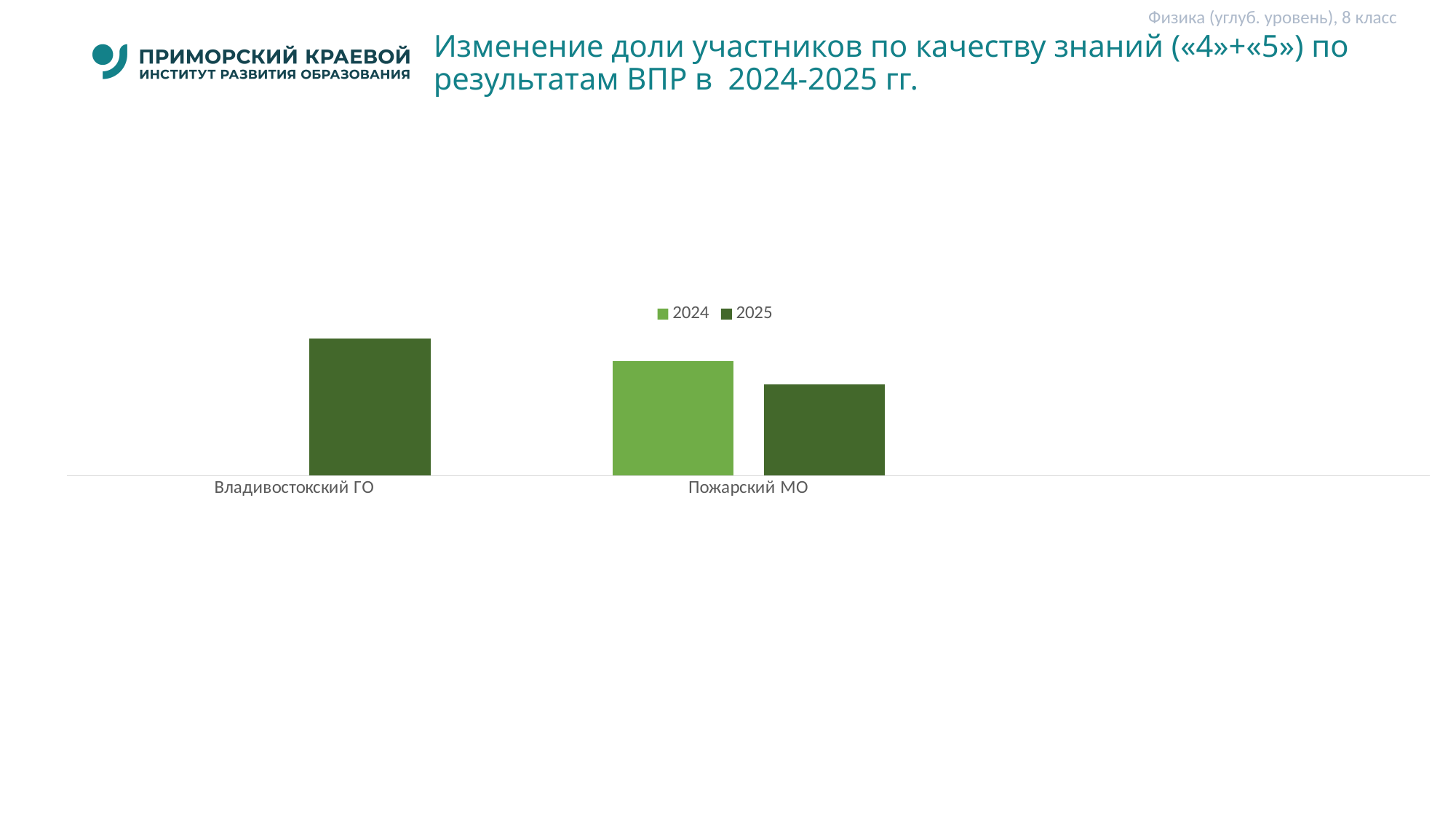
Which series does the legend list: what are the two entries? 2024 and 2025 Which category has the lowest 2025 bar? Пожарский МО Which category is shown on the left of the x axis? Владивостокский ГО Which category has a bar for only one of the two years? Владивостокский ГО What kind of chart is shown on the slide? bar chart How many series does the chart legend list? 2 Which category has the higher 2025 value, Владивостокский ГО or Пожарский МО? Владивостокский ГО Did the value for Пожарский МО rise or fall from 2024 to 2025? fall How many categories are shown on the x axis of the chart? 2 For Пожарский МО, which is larger: the 2024 value or the 2025 value? 2024 Which category has the highest 2025 bar? Владивостокский ГО